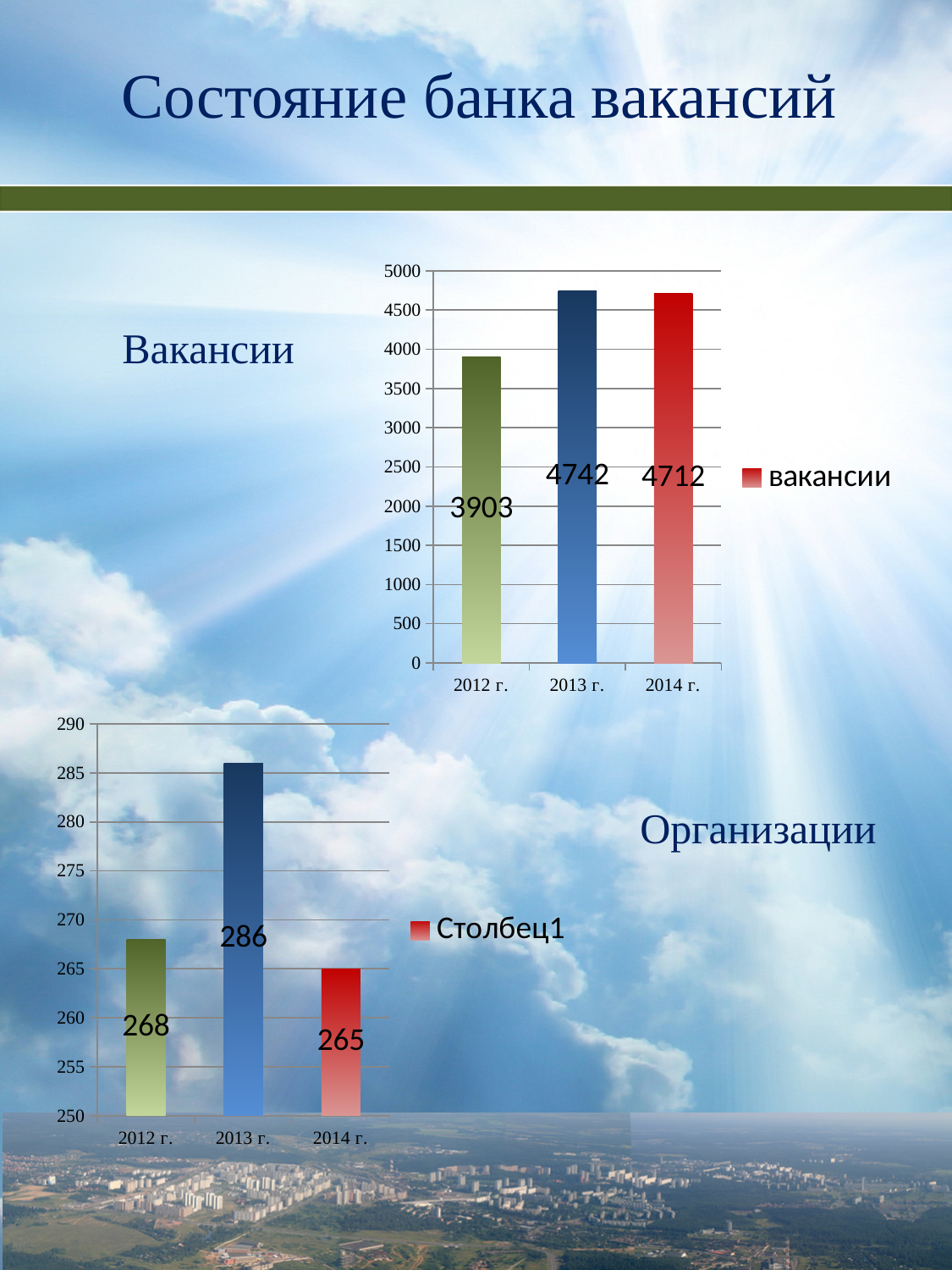
In the Вакансии chart, which year has the highest value? 2013 г. In the Вакансии chart, how many years are shown on the x axis? 3 In the Вакансии chart, which year has the lowest value? 2012 г. In the Вакансии chart, what is the value for 2013 г.? 4742 In the Организации chart, what is the value for 2014 г.? 265 In the Организации chart, which year has the lowest value? 2014 г. In the Вакансии chart, what is the difference between the values for 2013 г. and 2014 г.? 30 In the Организации chart, what is the difference between the values for 2013 г. and 2012 г.? 18 In the Организации chart, what is the value for 2013 г.? 286 What kind of chart is the Организации chart? bar chart In the Организации chart, is the value for 2012 г. greater or less than 270? less In the Вакансии chart, what is the value for 2012 г.? 3903